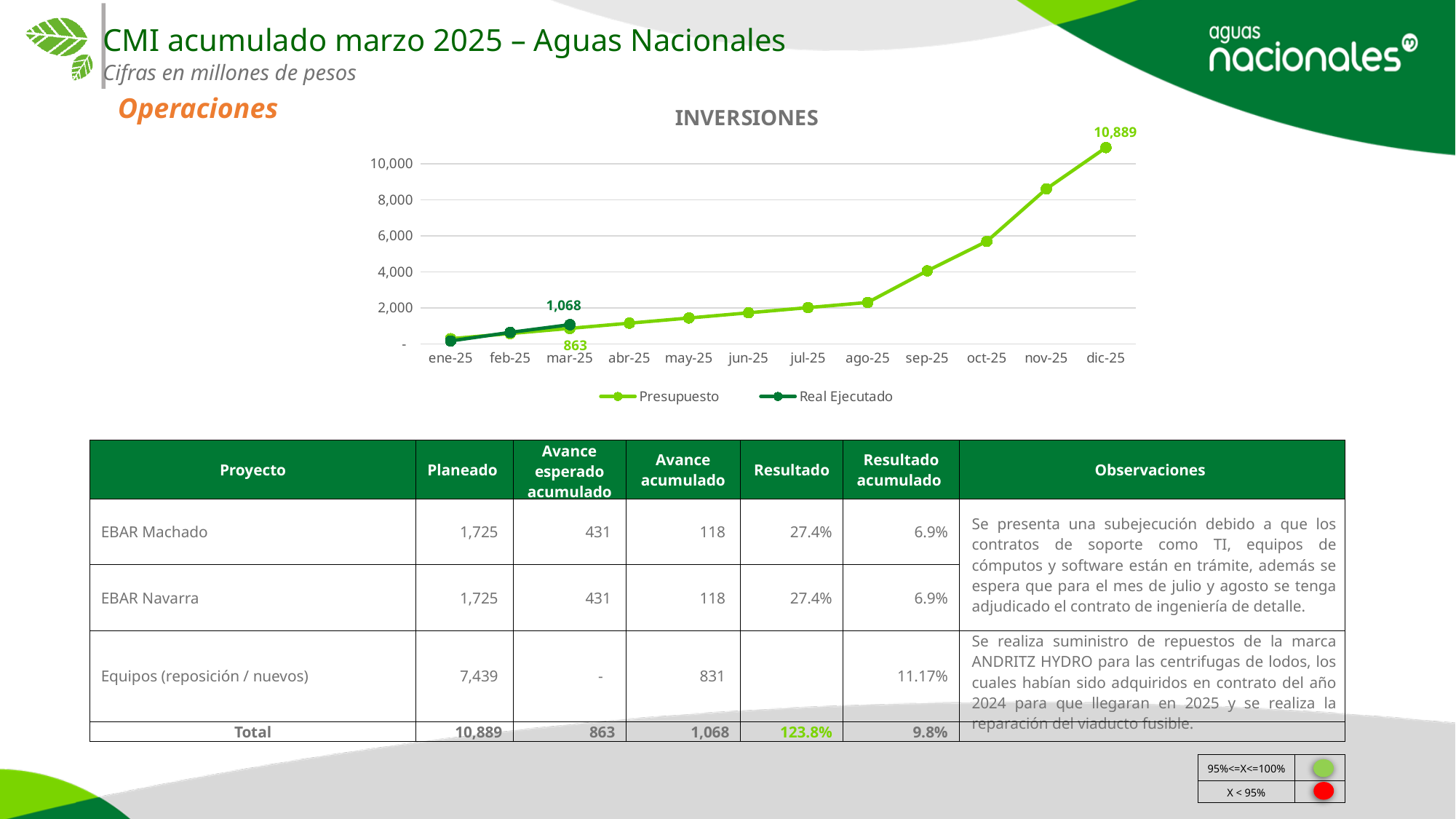
In the INVERSIONES chart, is the Presupuesto value for nov-25 greater or less than 8,000? greater How many months are shown on the x axis of the INVERSIONES chart? 12 In the INVERSIONES chart, what is the difference between Real Ejecutado and Presupuesto for mar-25? 205 In which month does the Presupuesto series reach its highest value in the INVERSIONES chart? dic-25 How many series does the legend of the INVERSIONES chart list? 2 What kind of chart is the INVERSIONES chart? line chart In the INVERSIONES chart, which series has the larger value for mar-25, Presupuesto or Real Ejecutado? Real Ejecutado What is the Real Ejecutado value for mar-25 in the INVERSIONES chart? 1,068 What is the Presupuesto value for dic-25 in the INVERSIONES chart? 10,889 What is the Presupuesto value for mar-25 in the INVERSIONES chart? 863 In the INVERSIONES chart, is the Presupuesto value for ago-25 greater or less than 4,000? less Does the Presupuesto line in the INVERSIONES chart rise or fall from ene-25 to dic-25? rise